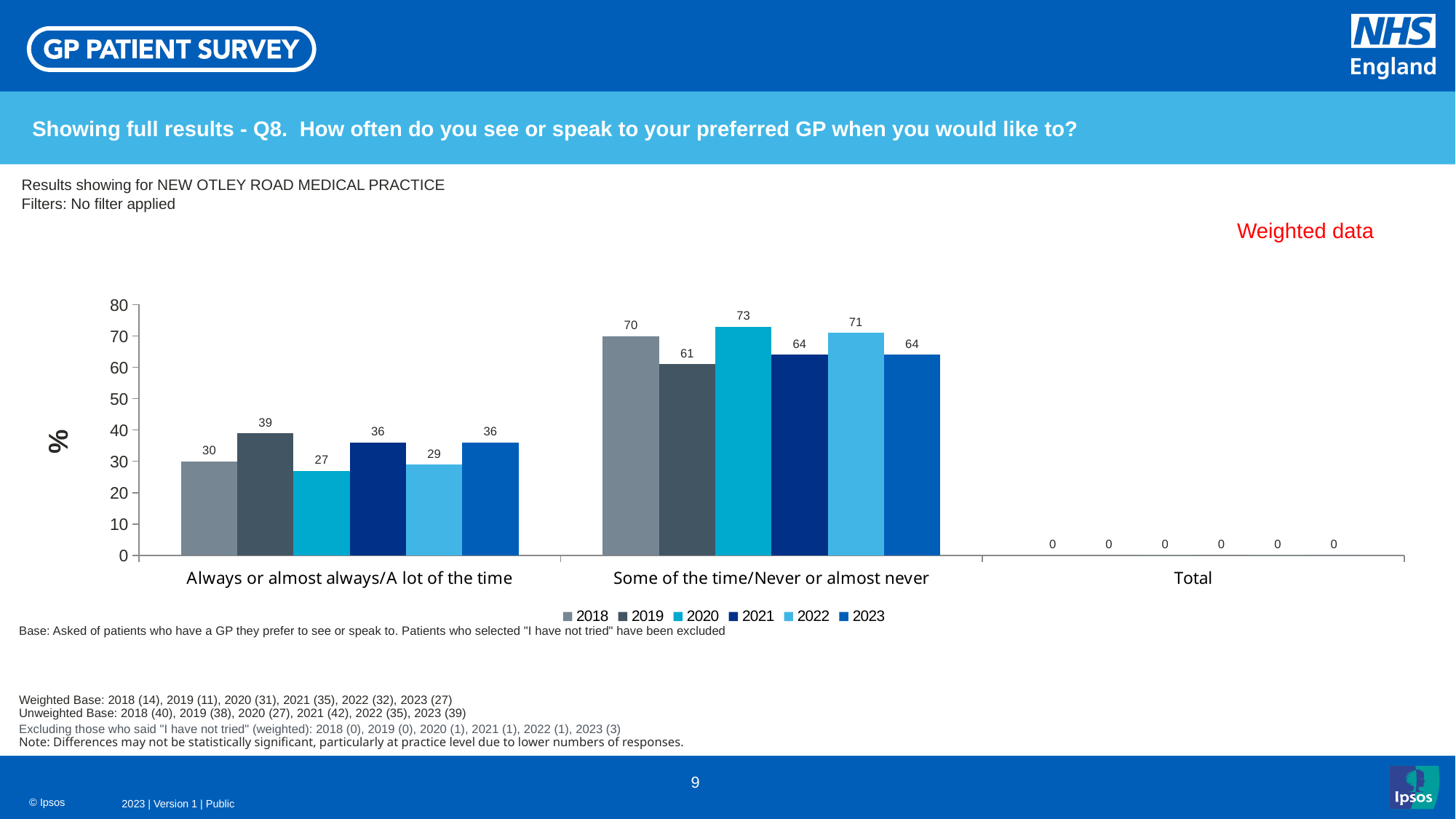
What is the value for 2023 in the 'Always or almost always/A lot of the time' category? 36 Which is larger in the 'Always or almost always/A lot of the time' category: the value for 2021 or the value for 2022? 2021 How many categories are shown on the x axis? 3 How many series does the legend list? 6 What is the label on the vertical axis of the chart? % What is the value for 2018 in the 'Always or almost always/A lot of the time' category? 30 What is the value for 2020 in the 'Some of the time/Never or almost never' category? 73 What kind of chart is shown on the slide? Bar chart What is the difference between the 2020 and 2019 values in the 'Some of the time/Never or almost never' category? 12 Which year has the lowest value in the 'Some of the time/Never or almost never' category? 2019 Is the value for 2022 in the 'Some of the time/Never or almost never' category greater or less than 60? greater Which year has the highest value in the 'Always or almost always/A lot of the time' category? 2019